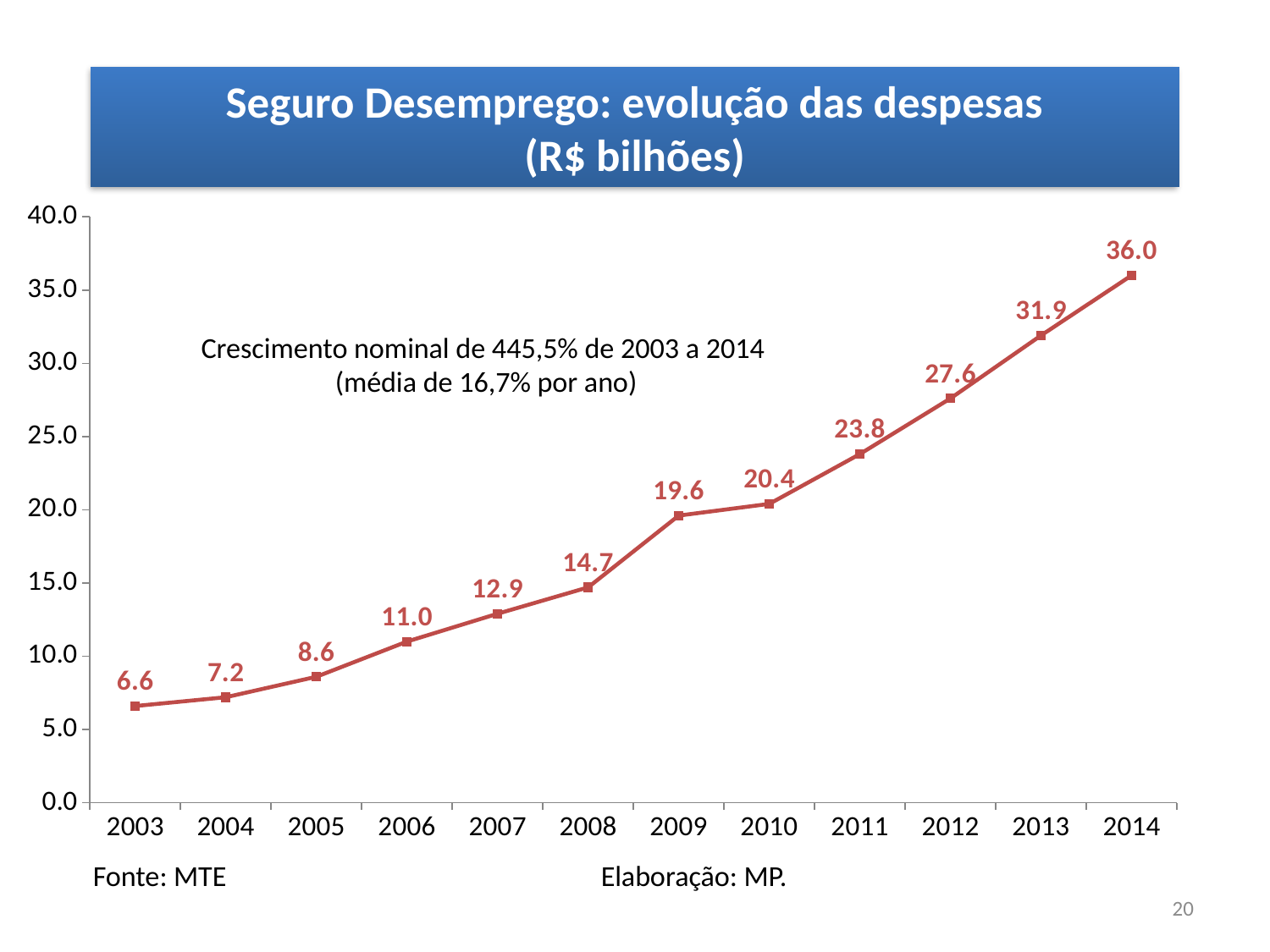
What is the difference between the values for 2010 and 2009? 0.8 What is the value for 2003? 6.6 What is the value for 2012? 27.6 What kind of chart is shown on the slide? line chart Is the value for 2013 greater or less than 30.0? greater What is the difference between the values for 2014 and 2003? 29.4 How many years are plotted on the chart? 12 Which year has the highest value? 2014 Which is larger, the value for 2008 or the value for 2011? 2011 What is the value for 2009? 19.6 Which year has the lowest value? 2003 Do the values rise or fall from 2003 to 2014? rise